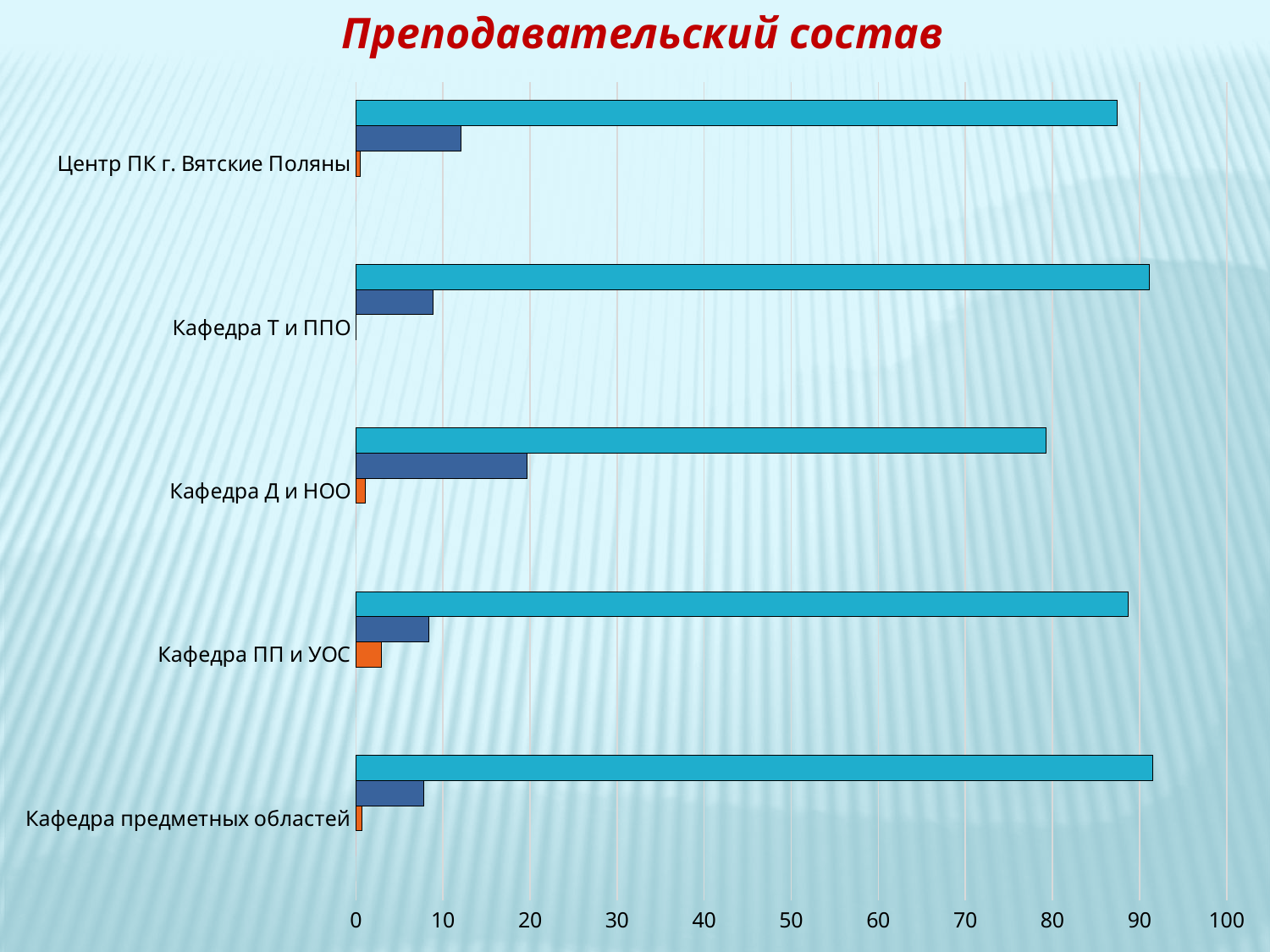
Which has the larger light blue bar: Кафедра Д и НОО or Центр ПК г. Вятские Поляны? Центр ПК г. Вятские Поляны What kind of chart is shown on the slide? bar chart Which category has the longest orange bar? Кафедра ПП и УОС How many bars are drawn for each category in the chart? 3 Which category has the shortest light blue bar? Кафедра Д и НОО Is the value of the dark blue bar for Кафедра Д и НОО greater or less than 10? greater Is the value of the light blue bar for Кафедра Т и ППО greater or less than 90? greater Which category has the longest dark blue bar? Кафедра Д и НОО Is the value of the dark blue bar for Центр ПК г. Вятские Поляны greater or less than 10? greater What is the title of the slide above the chart? Преподавательский состав How many categories are shown on the vertical axis of the chart? 5